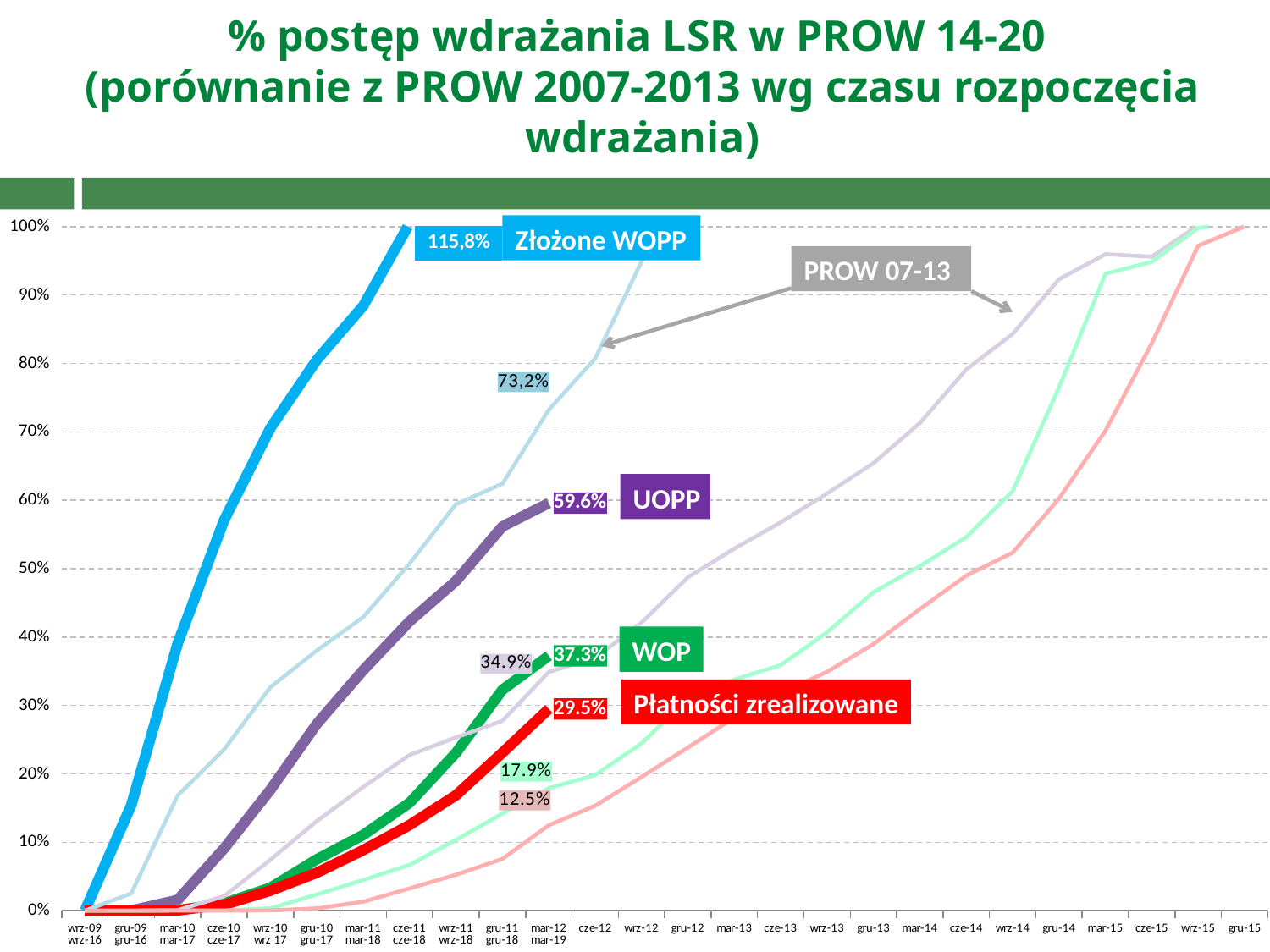
Which is larger, the labelled value for UOPP or for WOP? UOPP What type of chart is shown on the slide? line chart What is the difference between the labelled values for WOP (37.3%) and Płatności zrealizowane (29.5%)? 7.8% Which of the labelled PROW 14-20 series has the lowest value? Płatności zrealizowane What value is labelled for the UOPP series? 59.6% What value is labelled for the Złożone WOPP series? 115,8% Which of the labelled PROW 14-20 series has the highest value? Złożone WOPP What value is labelled for the WOP series? 37.3% Do the plotted series rise or fall along the x axis? rise Is the value of the UOPP series at its last point greater or less than 50%? greater What value is labelled for the Płatności zrealizowane series? 29.5% What is the highest value shown on the y axis? 100%